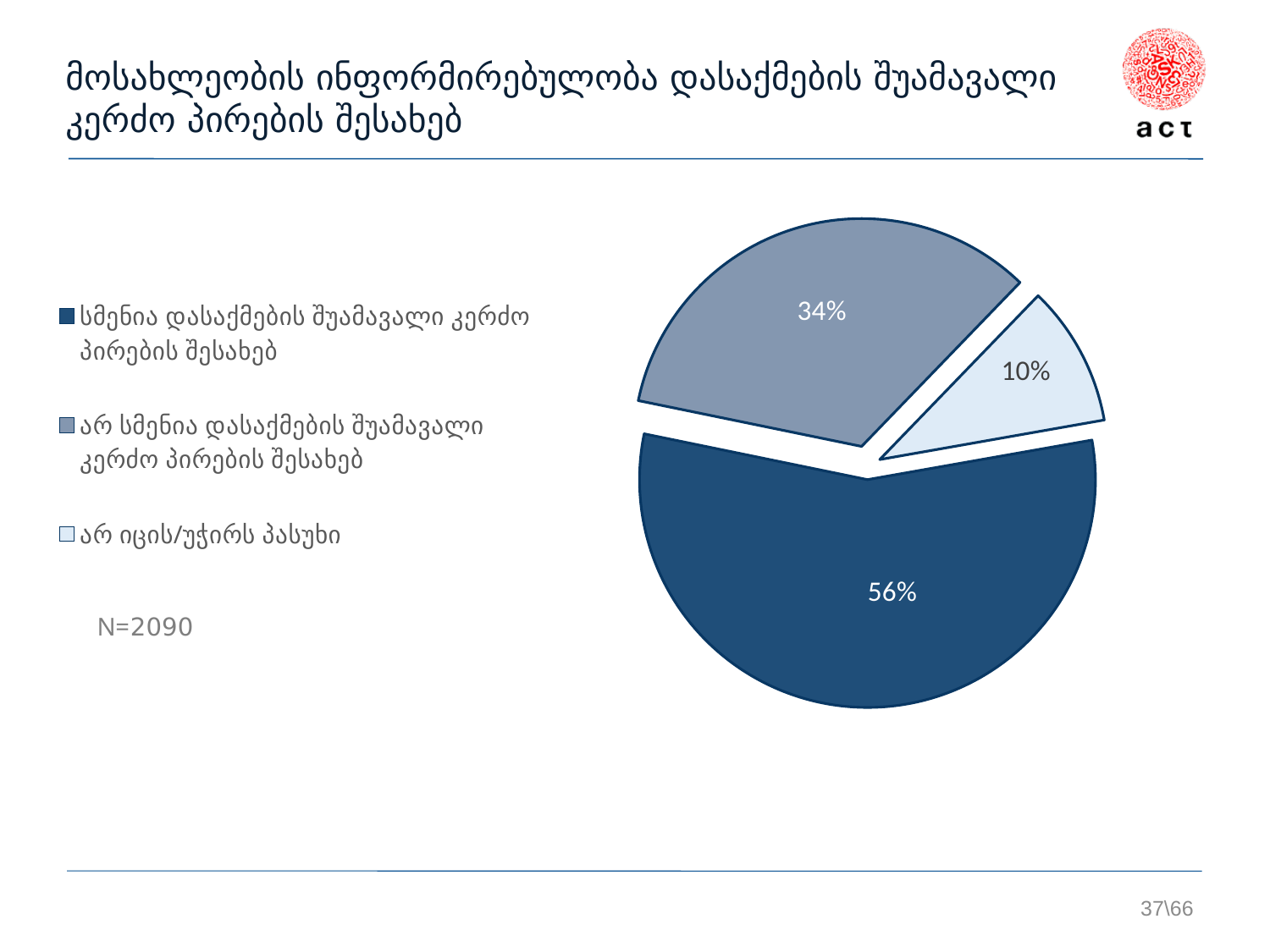
What share of the pie is labelled "არ იცის/უჭირს პასუხი"? 10% Which legend entry is shown in the lightest colour? არ იცის/უჭირს პასუხი How many slices does the pie chart have? 3 Which category has the largest slice of the pie? სმენია დასაქმების შუამავალი კერძო პირების შესახებ What share of the pie is labelled "არ სმენია დასაქმების შუამავალი კერძო პირების შესახებ"? 34% What type of chart is shown on the slide? Pie chart What is the difference in percentage points between the "სმენია" slice and the "არ სმენია" slice? 22 Which category has the smallest slice of the pie? არ იცის/უჭირს პასუხი Which is larger: the "არ სმენია დასაქმების შუამავალი კერძო პირების შესახებ" slice or the "არ იცის/უჭირს პასუხი" slice? არ სმენია დასაქმების შუამავალი კერძო პირების შესახებ What share of the pie is labelled "სმენია დასაქმების შუამავალი კერძო პირების შესახებ"? 56% What is the sample size (N) shown on the slide? N=2090 How many entries does the legend list? 3